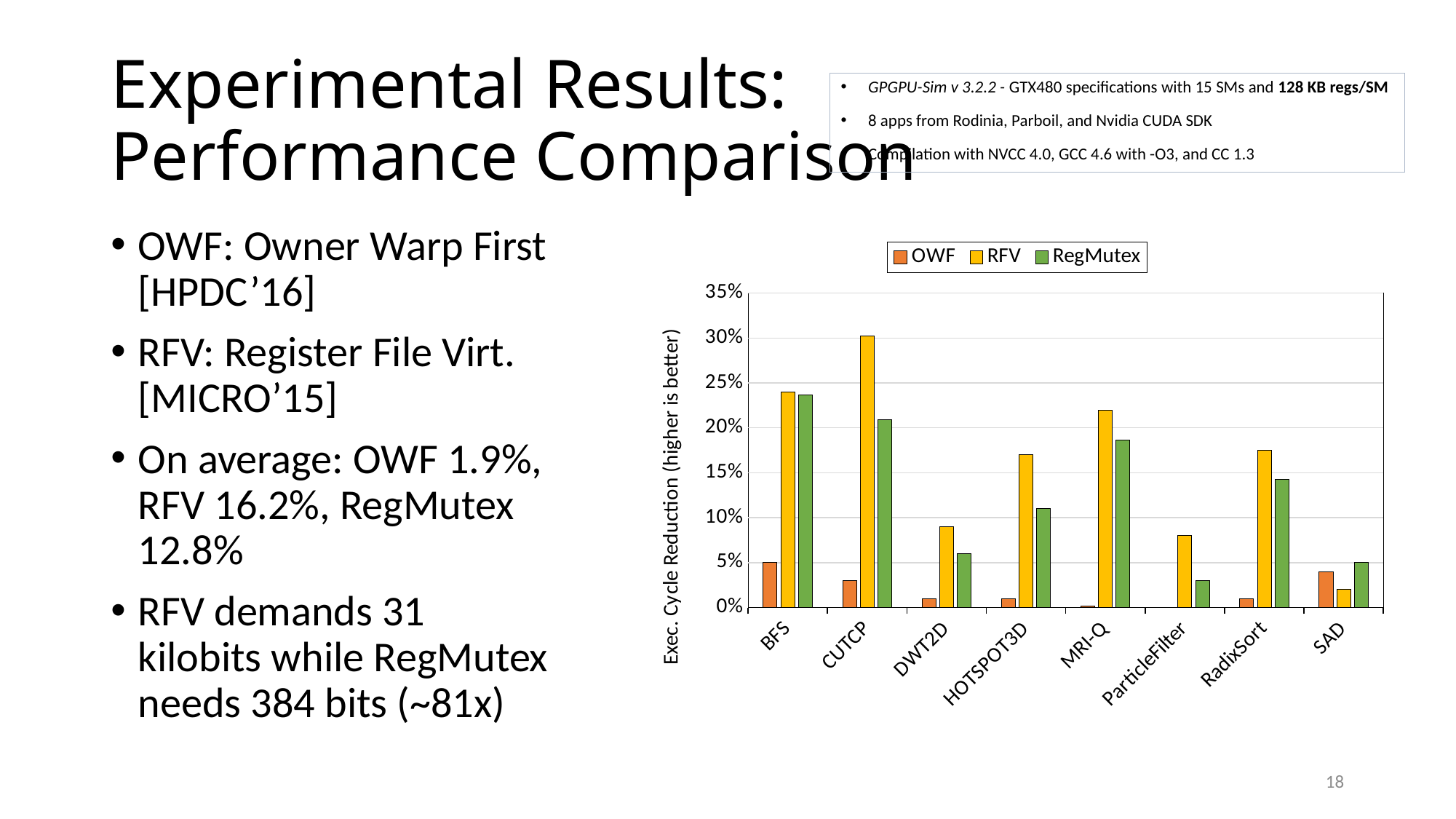
For SAD, which is larger: the RFV value or the RegMutex value? RegMutex Is the RFV value for MRI-Q greater or less than 20%? greater Which application has the highest RFV value in the chart? CUTCP Which application has the lowest RFV value in the chart? SAD For HOTSPOT3D, which is larger: the RFV value or the RegMutex value? RFV Is the RegMutex value for ParticleFilter greater or less than 5%? less Is the RegMutex value for BFS greater or less than 20%? greater What is the label of the y axis of the chart? Exec. Cycle Reduction (higher is better) How many series does the legend of the chart list? 3 What kind of chart is shown on the slide? bar chart How many application categories are shown on the x axis of the chart? 8